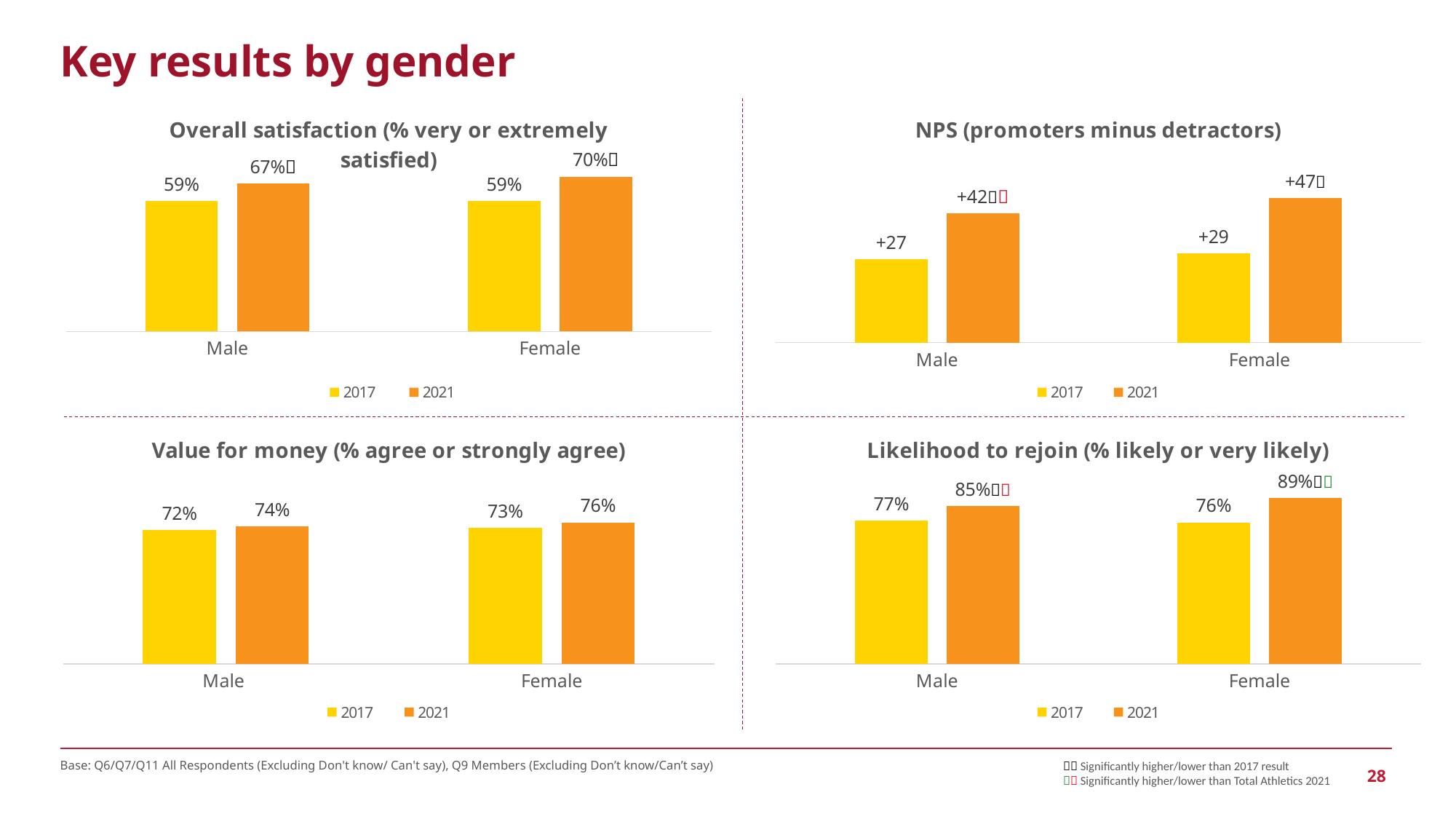
In the 'Likelihood to rejoin' chart, what is the 2017 value for Male? 77% In the 'Overall satisfaction' chart, what is the 2021 value for Female? 70% In the 'Value for money' chart, which is larger: the 2021 value for Male or the 2021 value for Female? Female 2021 What type of chart is the 'NPS (promoters minus detractors)' chart? Bar chart In the 'Value for money' chart, what is the 2021 value for Female? 76% How many series does the legend list in the 'Likelihood to rejoin' chart? 2 In the 'NPS (promoters minus detractors)' chart, what is the 2021 value for Male? +42 In the 'Overall satisfaction' chart, what is the difference between the 2021 and 2017 values for Male? 8 percentage points In the 'NPS (promoters minus detractors)' chart, which bar is the lowest? Male 2017 In the 'Likelihood to rejoin' chart, which bar is the highest? Female 2021 In the 'NPS (promoters minus detractors)' chart, what is the 2017 value for Female? +29 In the 'Overall satisfaction' chart, what is the 2017 value for Male? 59%